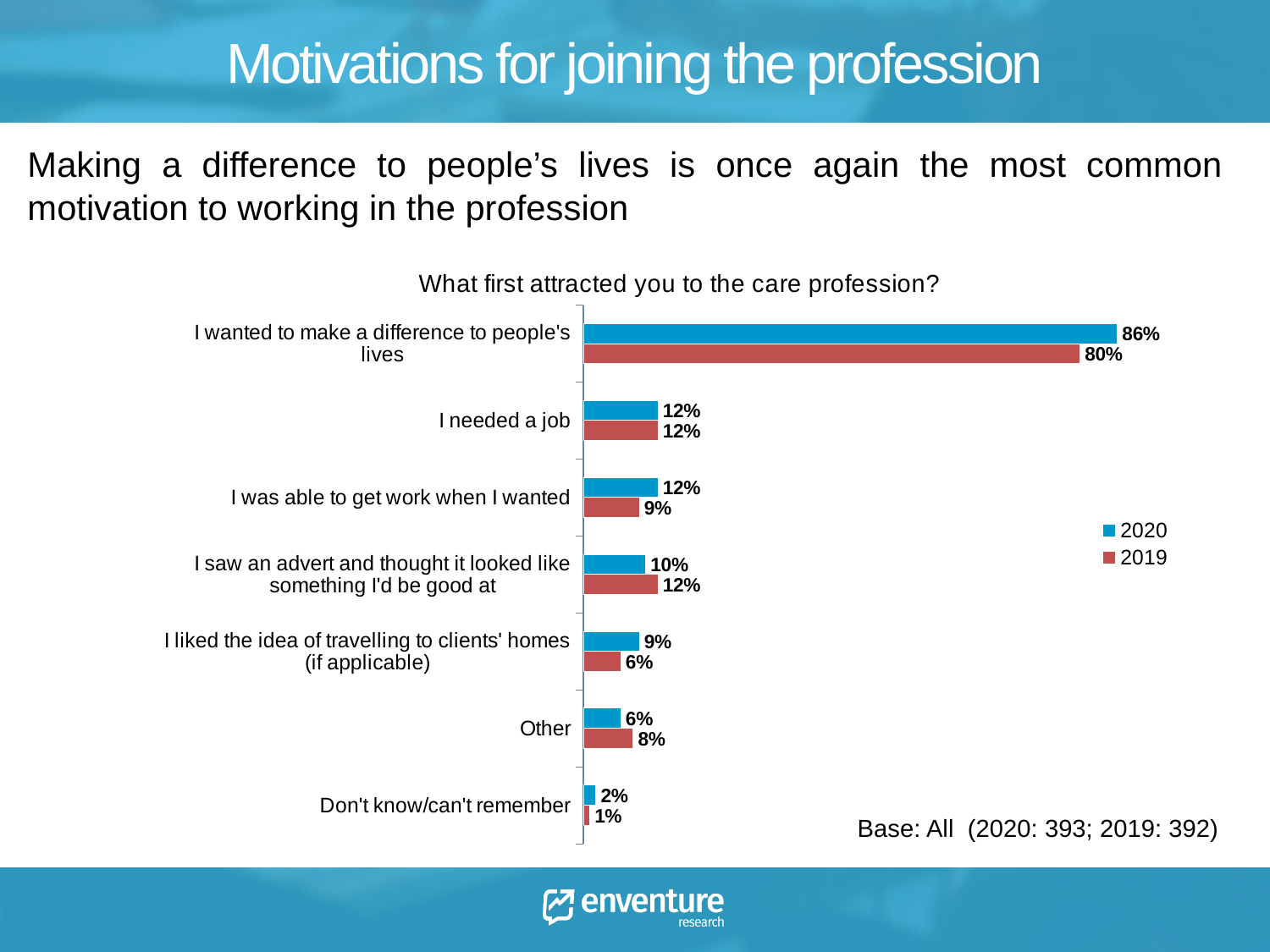
How many series does the legend list? 2 Which category has the lowest 2019 value? Don't know/can't remember What is the 2020 value for "I liked the idea of travelling to clients' homes (if applicable)"? 9% What is the difference between the 2020 and 2019 values for "I wanted to make a difference to people's lives"? 6% Which is larger for "I was able to get work when I wanted": the 2020 value or the 2019 value? 2020 What is the 2019 value for "I saw an advert and thought it looked like something I'd be good at"? 12% Which category has the highest 2020 value? I wanted to make a difference to people's lives What is the 2020 value for "I wanted to make a difference to people's lives"? 86% What is the title of the chart? What first attracted you to the care profession? What kind of chart is shown on the slide? Bar chart What is the 2019 value for "Other"? 8% How many categories are shown on the chart? 7